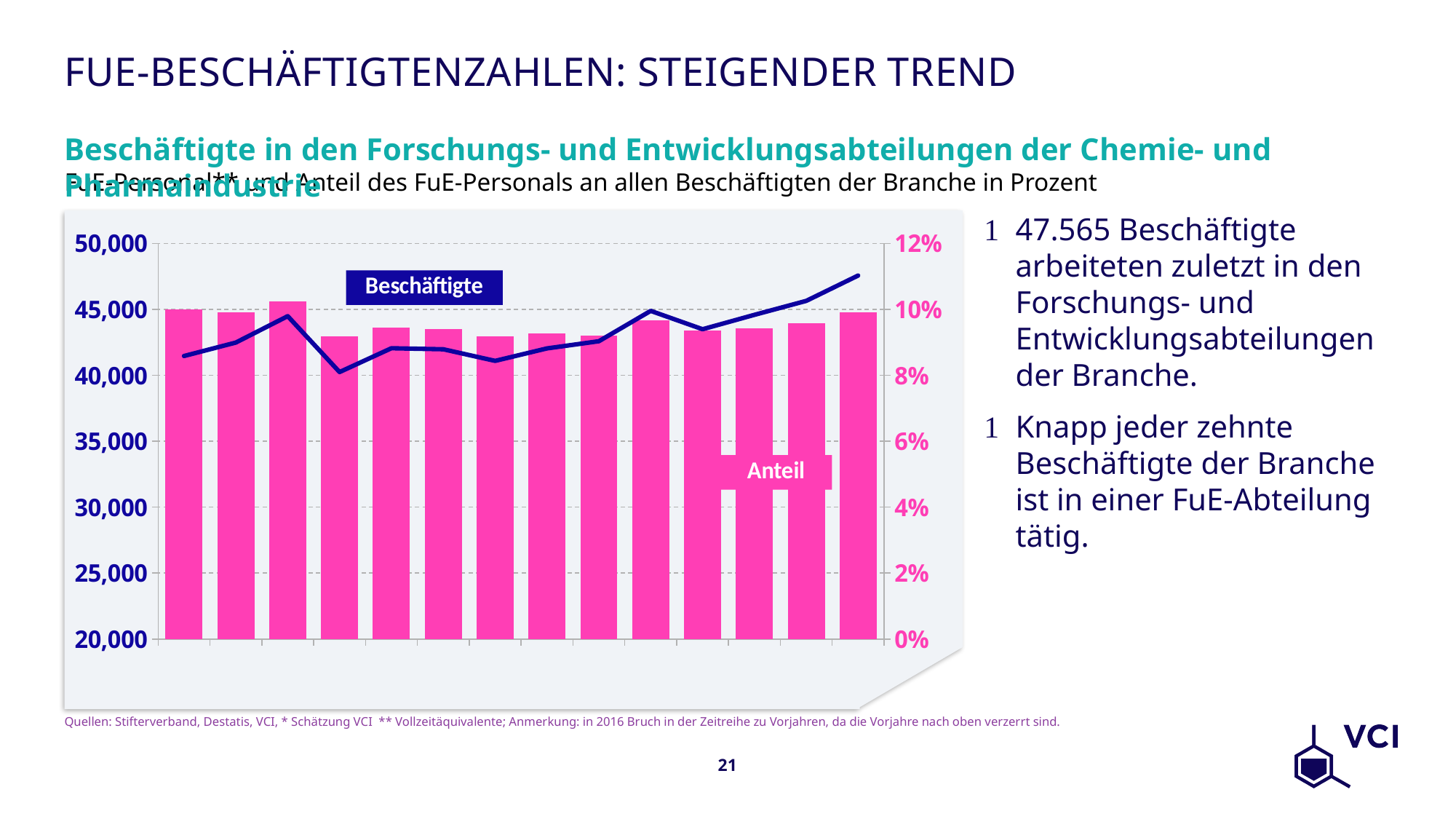
Which bar is the tallest in the chart, counting from the left? The third bar What are the names of the two series shown in the chart? Beschäftigte and Anteil How many data series does the chart show? 2 Which series is drawn as a line in the chart? Beschäftigte How many bars are plotted in the chart? 14 What kind of chart is shown on the slide? A combined bar and line chart